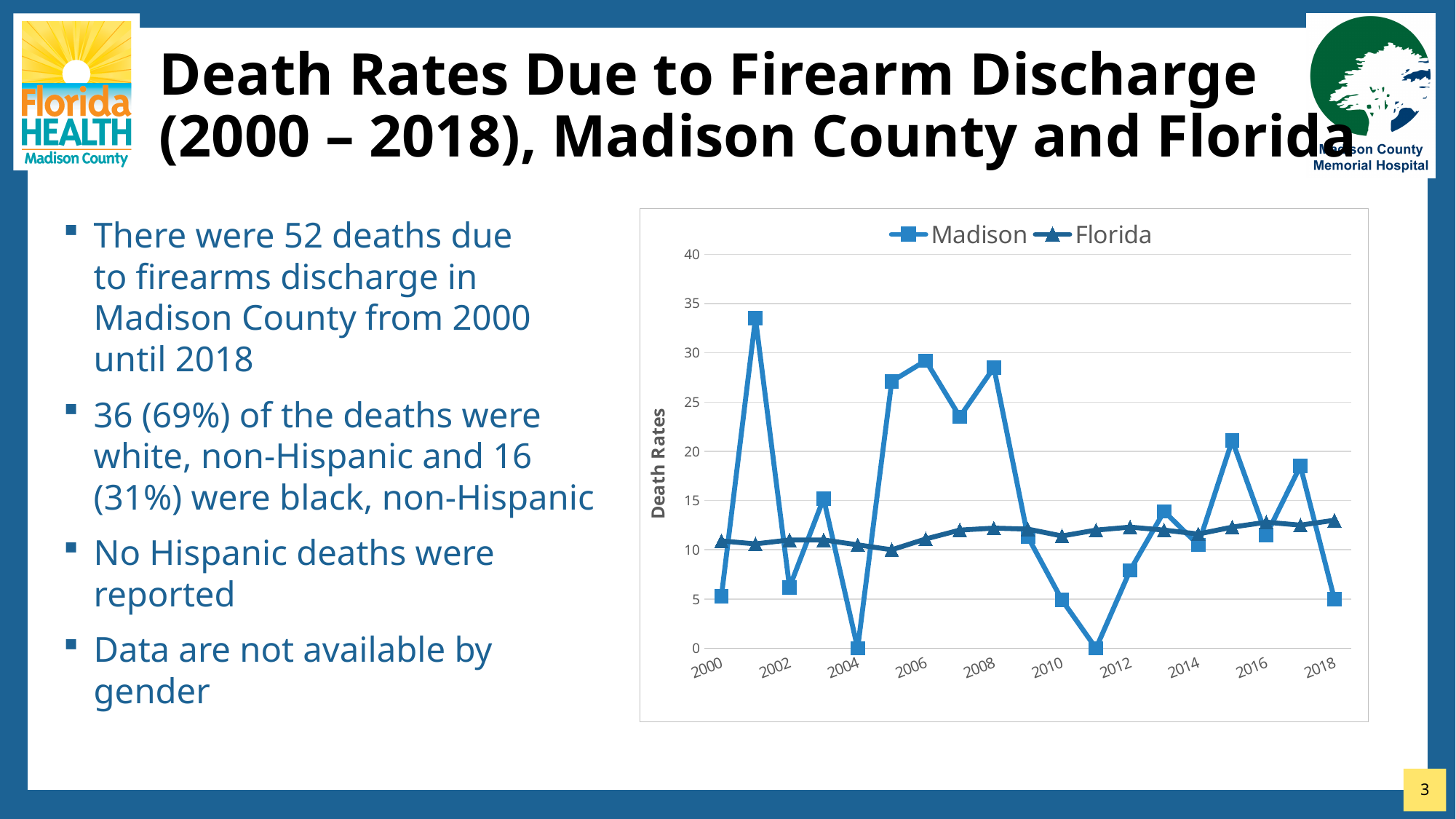
In 2001, which series has the larger value, Madison or Florida? Madison What kind of chart is shown on the slide? line chart Is the Madison value for 2010 greater or less than 10? less What is the Madison death rate in 2004? 0 How many years are plotted along the x axis of the chart? 19 What is the Madison death rate in 2011? 0 Is the Florida value for 2018 greater or less than 15? less What are the two series named in the chart legend? Madison and Florida How many series does the chart legend list? 2 What is the label on the vertical axis of the chart? Death Rates In which year does the Madison series reach its highest value? 2001 Is the Madison value for 2001 greater or less than 30? greater